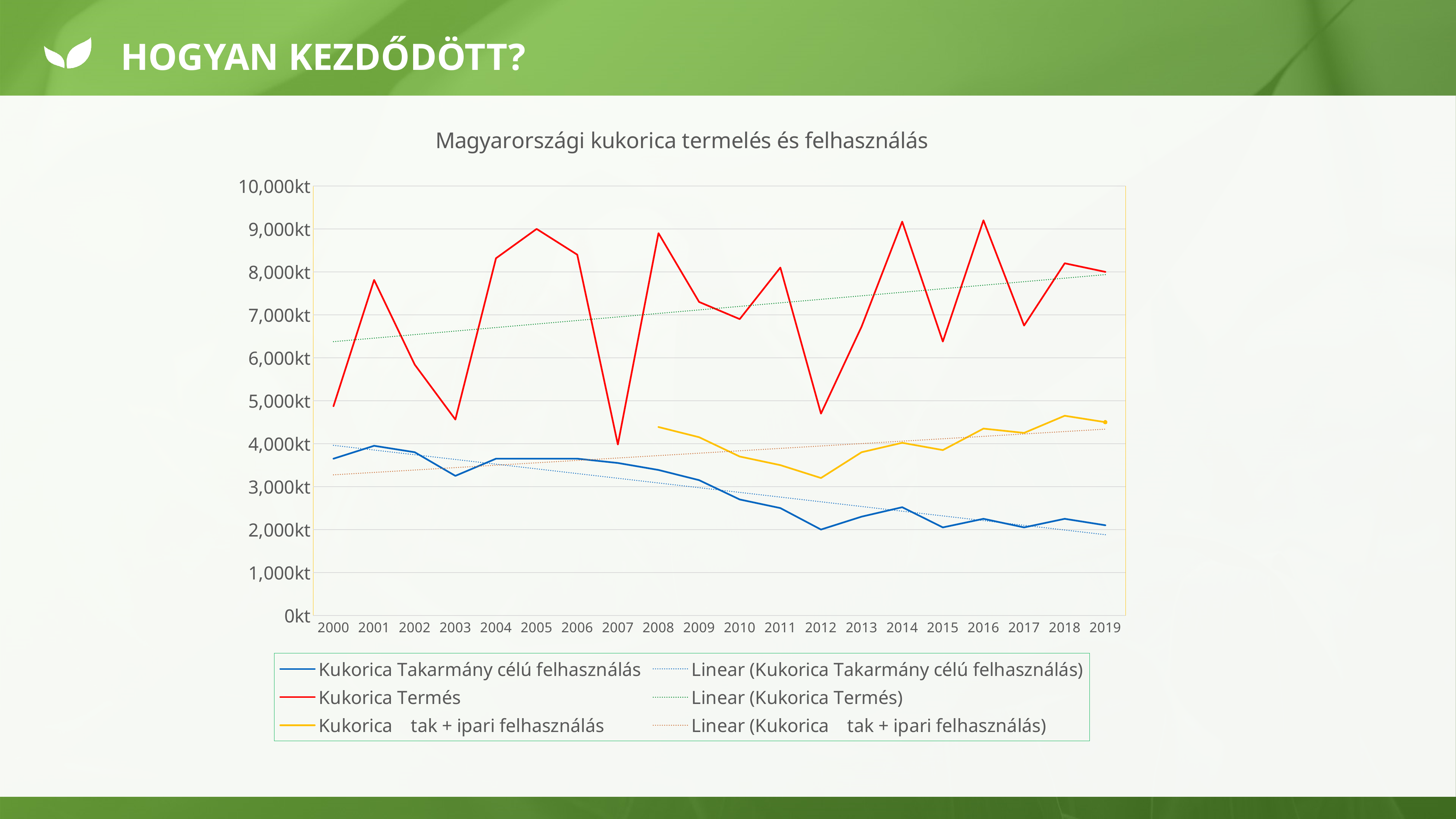
Is the Kukorica Termés value for 2005 greater or less than 8,000kt? greater In which year is Kukorica Termés at its lowest? 2007 How many entries does the chart legend list? 6 What colour is the Kukorica Termés line? red In which year is Kukorica tak + ipari felhasználás at its lowest? 2012 How many years are shown on the x axis of the chart? 20 What kind of chart is shown on the slide? line chart Is the Kukorica Termés value for 2007 greater or less than 5,000kt? less What is the title of the chart? Magyarországi kukorica termelés és felhasználás Is the Kukorica tak + ipari felhasználás value for 2012 greater or less than 4,000kt? less Does Kukorica Takarmány célú felhasználás generally rise or fall from 2000 to 2019? fall